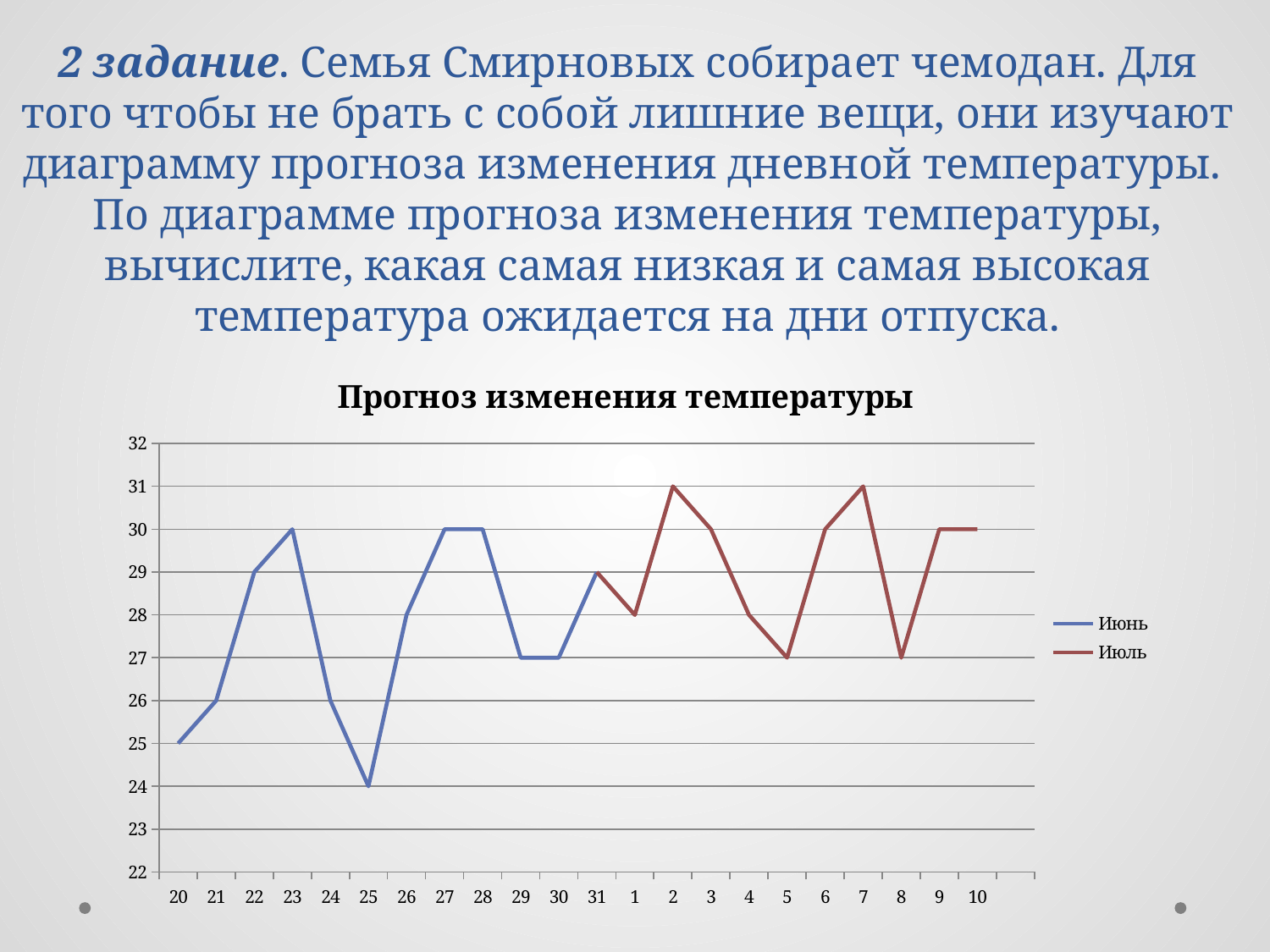
How many series does the legend list? 2 What is the temperature value for day 2 in the Июль series? 31 What is the highest temperature value plotted on the chart? 31 What kind of chart is shown on the slide? line chart What is the lowest temperature value plotted on the chart? 24 What is the difference between the Июнь values for day 23 and day 25? 6 What is the temperature value for day 25 in the Июнь series? 24 What are the two series named in the legend? Июнь and Июль Which is larger: the Июнь value for day 22 or the Июль value for day 1? Июнь value for day 22 What is the title of the chart? Прогноз изменения температуры How many days are labelled along the x axis? 22 Do the Июнь values rise or fall from day 20 to day 23? rise